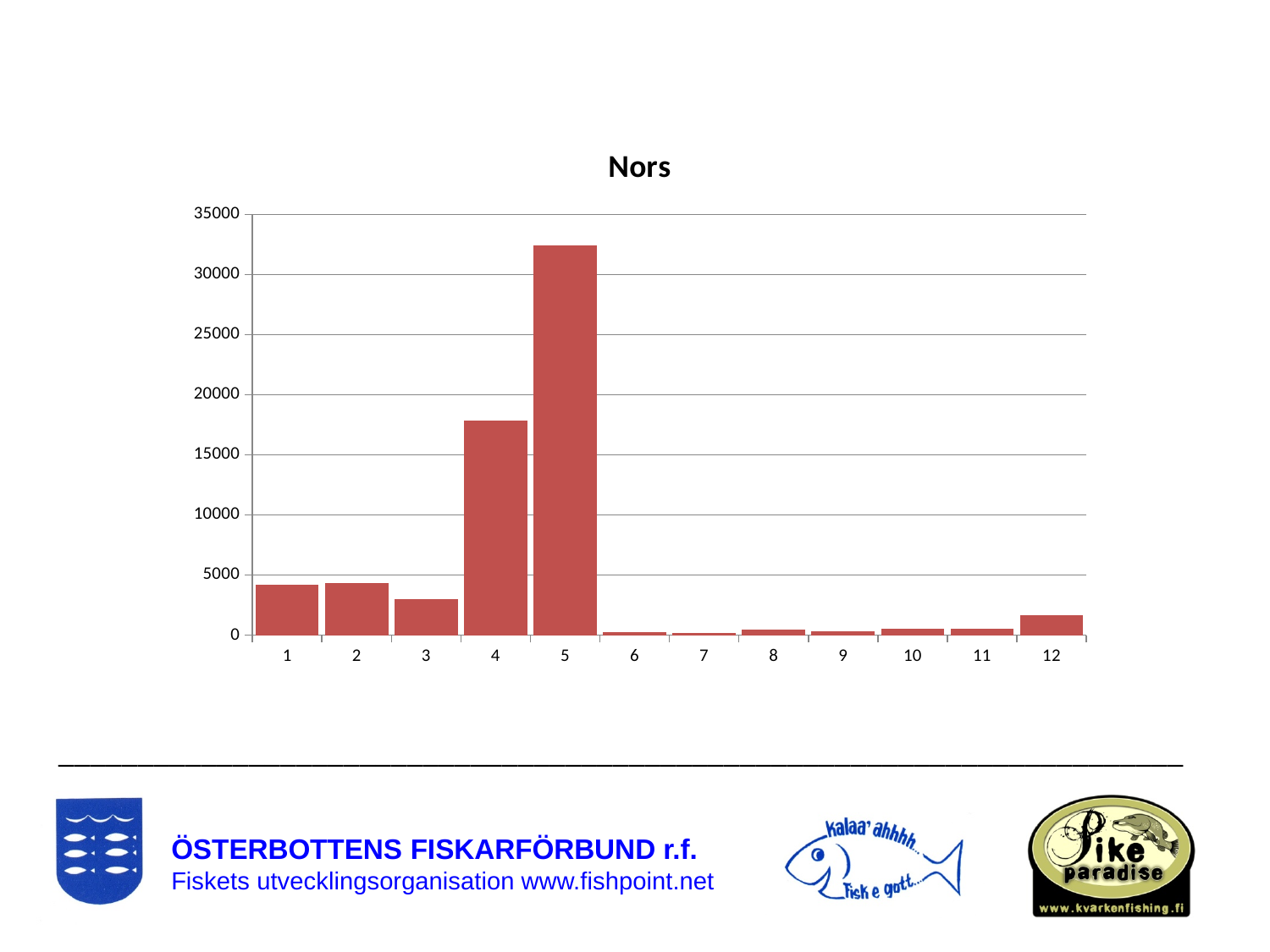
Which is larger, the value for category 1 or the value for category 4? 4 Is the value for category 5 greater or less than 30000? greater Is the value for category 4 greater or less than 15000? greater Is the value for category 12 greater or less than 5000? less What kind of chart is shown on the slide? bar chart How many categories are shown on the x axis of the chart? 12 What is the title of the chart? Nors Which is larger, the value for category 12 or the value for category 10? 12 Which is larger, the value for category 4 or the value for category 5? 5 Which category has the highest value in the chart? 5